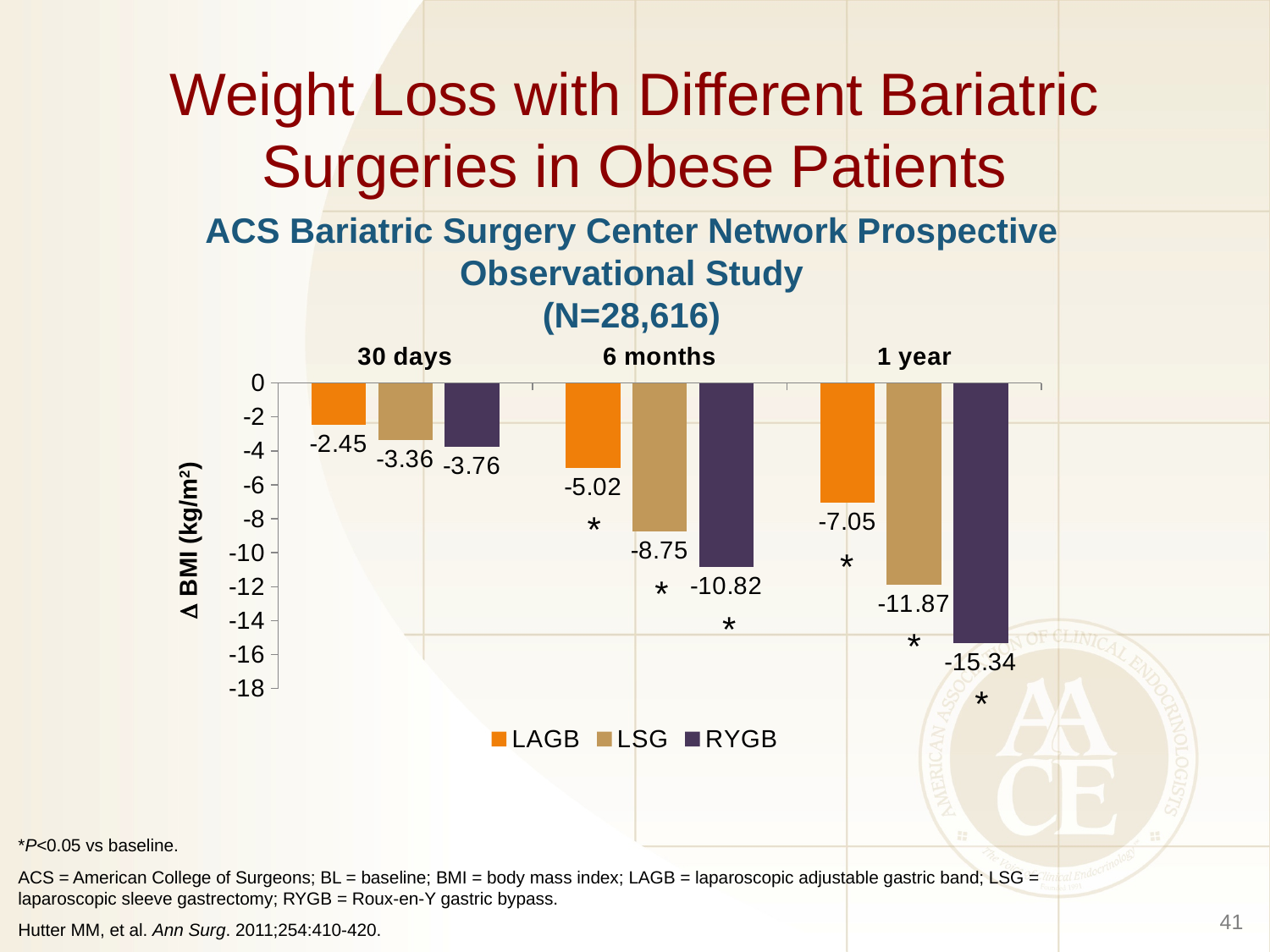
How many series does the legend list? 3 Which has a larger BMI reduction at 6 months, LAGB or LSG? LSG What is the difference between the LSG and LAGB values at 1 year? 4.82 What is the difference between the RYGB values at 6 months and at 30 days? 7.06 Which surgery shows the smallest BMI reduction at 30 days? LAGB Which surgery shows the largest BMI reduction at 1 year? RYGB What is the change in BMI for RYGB at 1 year? -15.34 What is the change in BMI for LSG at 6 months? -8.75 What is the change in BMI for LAGB at 30 days? -2.45 Does the BMI change for RYGB become more negative or less negative from 30 days to 1 year? More negative How many time points are shown on the x axis? 3 What kind of chart is shown on the slide? Bar chart